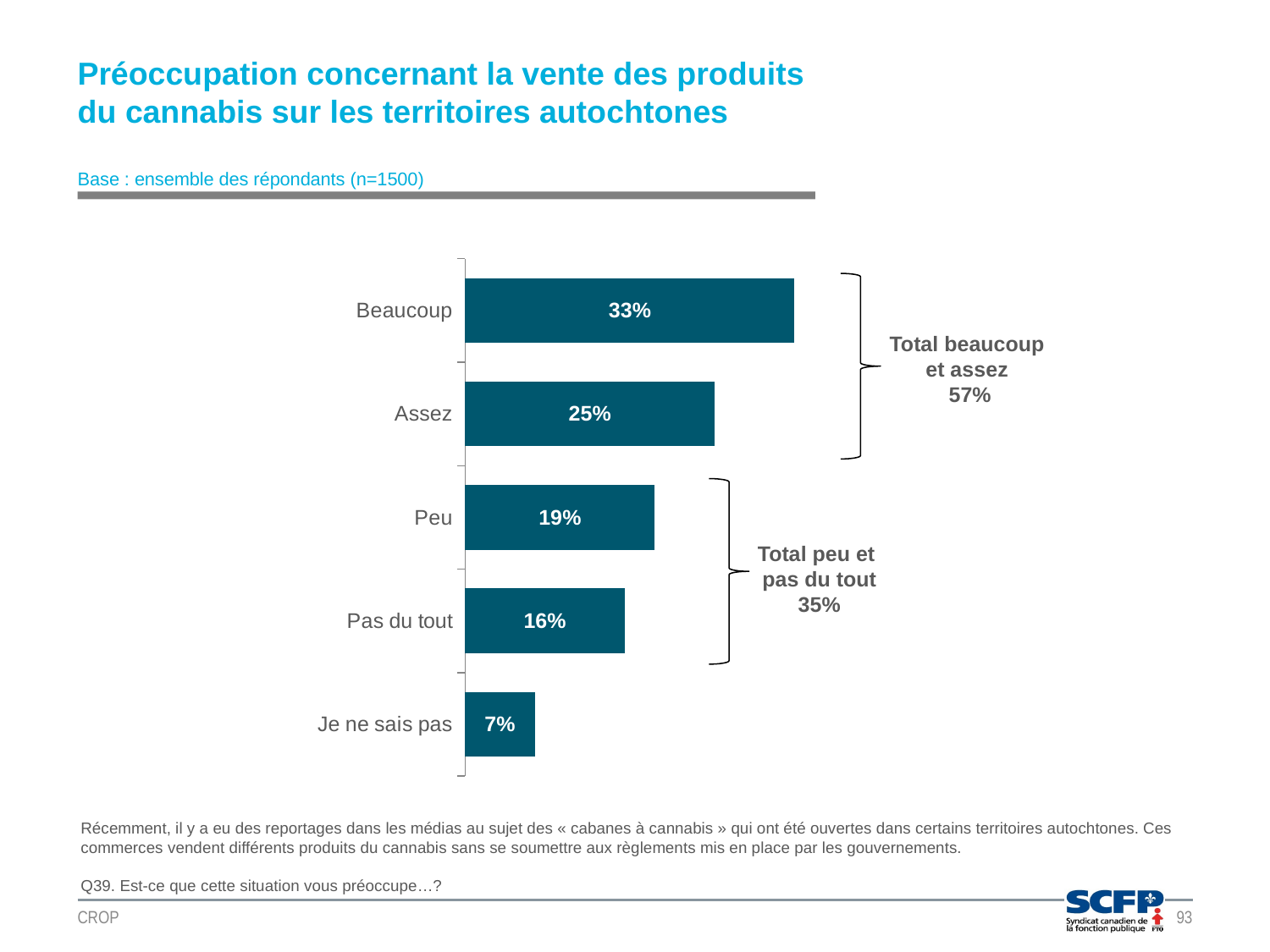
How many categories are shown in the chart? 5 Which is larger, the value for "Peu" or the value for "Pas du tout"? Peu What is the value for "Beaucoup"? 33% What is the value for "Peu"? 19% Which category has the lowest value? Je ne sais pas What is the value for "Je ne sais pas"? 7% What is the value for "Pas du tout"? 16% What is the value for "Assez"? 25% What kind of chart is shown on the slide? Bar chart What total is shown for "Total beaucoup et assez"? 57% What is the difference between the values for "Beaucoup" and "Assez"? 8% Which category has the highest value? Beaucoup